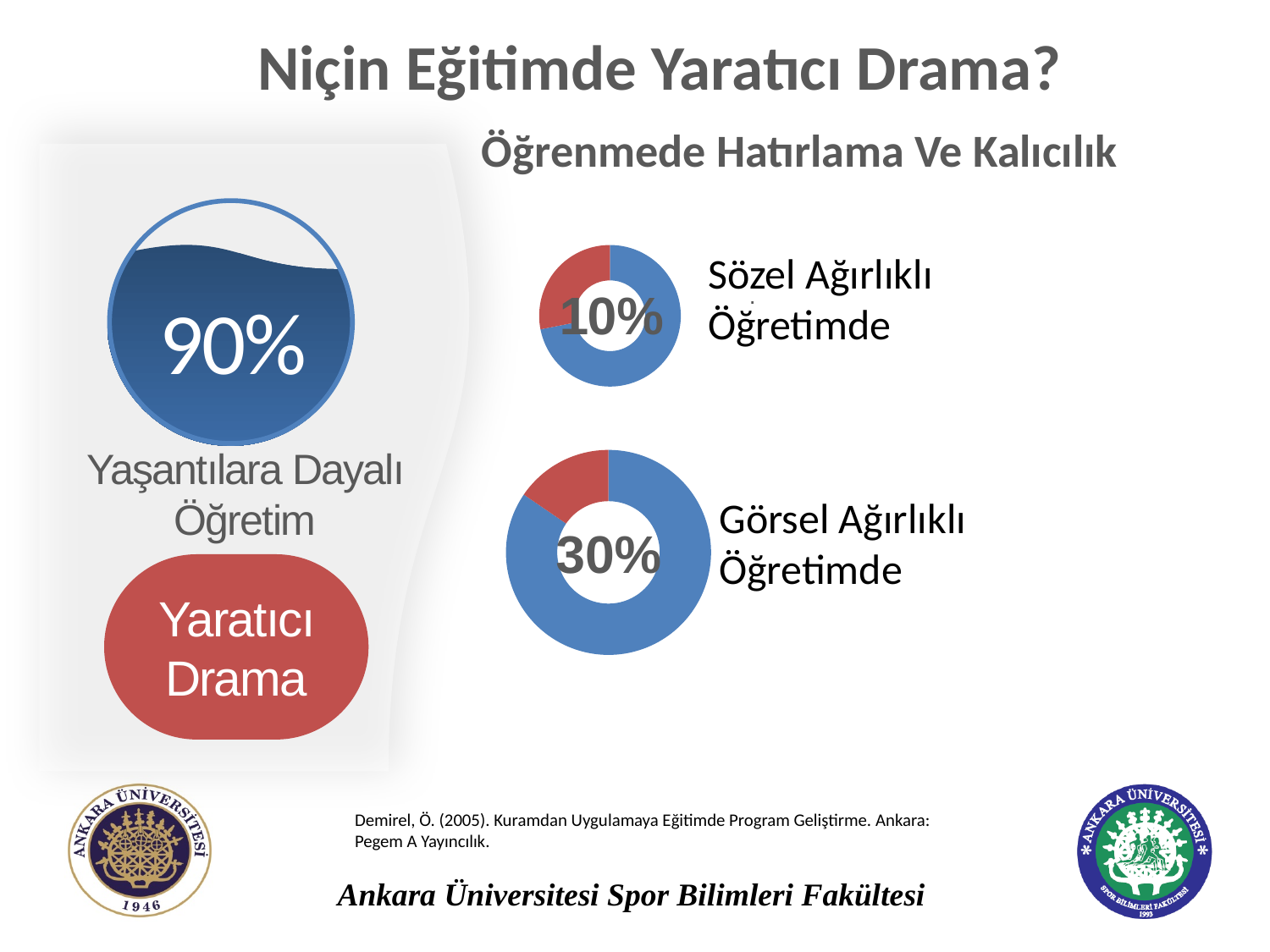
In the doughnut chart labelled 'Sözel Ağırlıklı Öğretimde', what percentage is shown? 10% What colour is the highlighted (smaller) slice in the two doughnut charts? Red How many doughnut charts are shown on the slide? 2 What kind of chart is used for 'Sözel Ağırlıklı Öğretimde' and 'Görsel Ağırlıklı Öğretimde'? Doughnut chart What is the subtitle shown above the doughnut charts? Öğrenmede Hatırlama Ve Kalıcılık Of the three teaching approaches shown with percentages on the slide, which has the highest value? Yaşantılara Dayalı Öğretim Of the three teaching approaches shown with percentages on the slide, which has the lowest value? Sözel Ağırlıklı Öğretimde Which is larger, the value for 'Sözel Ağırlıklı Öğretimde' or for 'Görsel Ağırlıklı Öğretimde'? Görsel Ağırlıklı Öğretimde What percentage is shown in the large circle labelled 'Yaşantılara Dayalı Öğretim'? 90% What is the difference between the 'Görsel Ağırlıklı Öğretimde' value and the 'Sözel Ağırlıklı Öğretimde' value? 20% In the 'Görsel Ağırlıklı Öğretimde' doughnut chart, what share does the red slice represent? 30% In the doughnut chart labelled 'Görsel Ağırlıklı Öğretimde', what percentage is shown? 30%